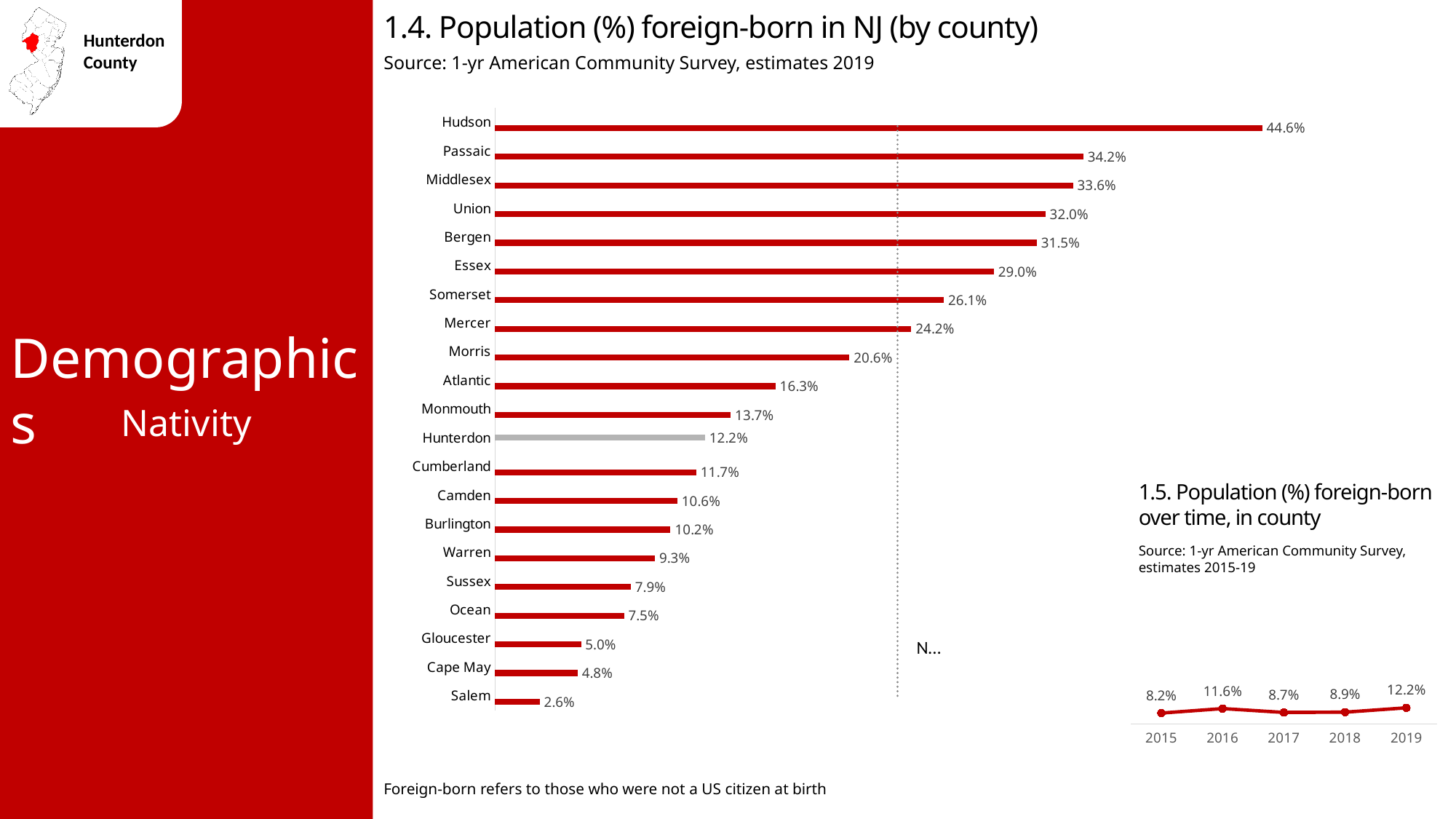
In the chart '1.4. Population (%) foreign-born in NJ (by county)', what is the value for Hunterdon? 12.2% In the chart '1.4. Population (%) foreign-born in NJ (by county)', which county has the highest value? Hudson In the chart '1.4. Population (%) foreign-born in NJ (by county)', what is the value for Mercer? 24.2% In the chart '1.4. Population (%) foreign-born in NJ (by county)', what is the difference between Hudson and Passaic? 10.4% How many counties are shown in the chart '1.4. Population (%) foreign-born in NJ (by county)'? 21 In the chart '1.5. Population (%) foreign-born over time, in county', what is the difference between 2019 and 2015? 4.0% In the chart '1.4. Population (%) foreign-born in NJ (by county)', which is larger, Bergen or Essex? Bergen How many data points are plotted in the chart '1.5. Population (%) foreign-born over time, in county'? 5 In the chart '1.5. Population (%) foreign-born over time, in county', which year has the highest value? 2019 In the chart '1.4. Population (%) foreign-born in NJ (by county)', which county has the lowest value? Salem What type of chart is '1.4. Population (%) foreign-born in NJ (by county)'? Bar chart In the chart '1.5. Population (%) foreign-born over time, in county', what is the value for 2016? 11.6%